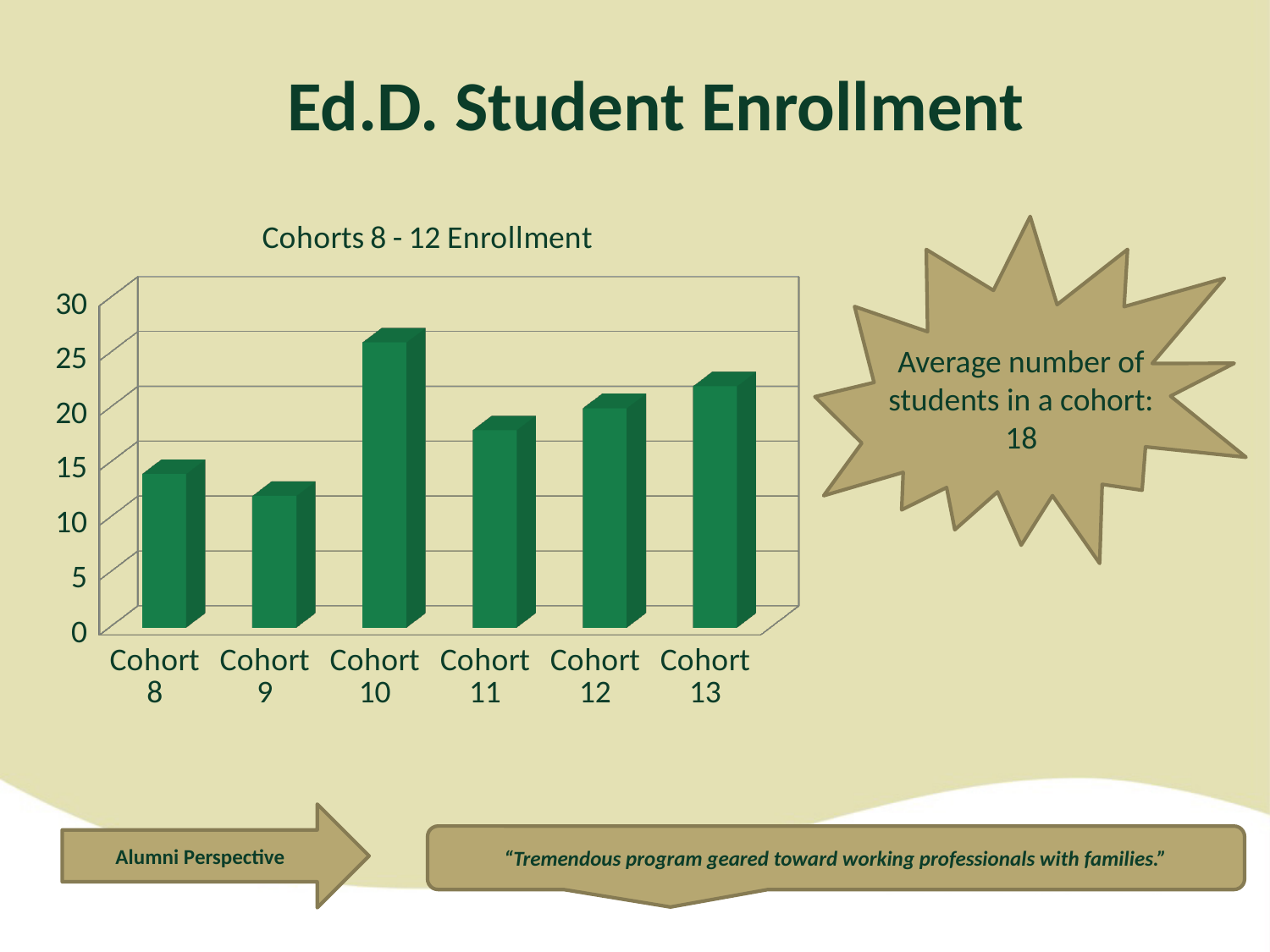
Is the value for Cohort 9 greater or less than 15? less What is the title of the chart? Cohorts 8 - 12 Enrollment Which has the larger enrollment, Cohort 10 or Cohort 8? Cohort 10 How many cohorts are plotted on the chart? 6 Is the value for Cohort 8 greater or less than 20? less Which cohort has the highest enrollment? Cohort 10 Which cohort has the lowest enrollment? Cohort 9 What kind of chart is shown on the slide? bar chart Which has the larger enrollment, Cohort 13 or Cohort 11? Cohort 13 From Cohort 11 to Cohort 13, do the enrollment values rise or fall? rise Is the value for Cohort 12 greater or less than 15? greater